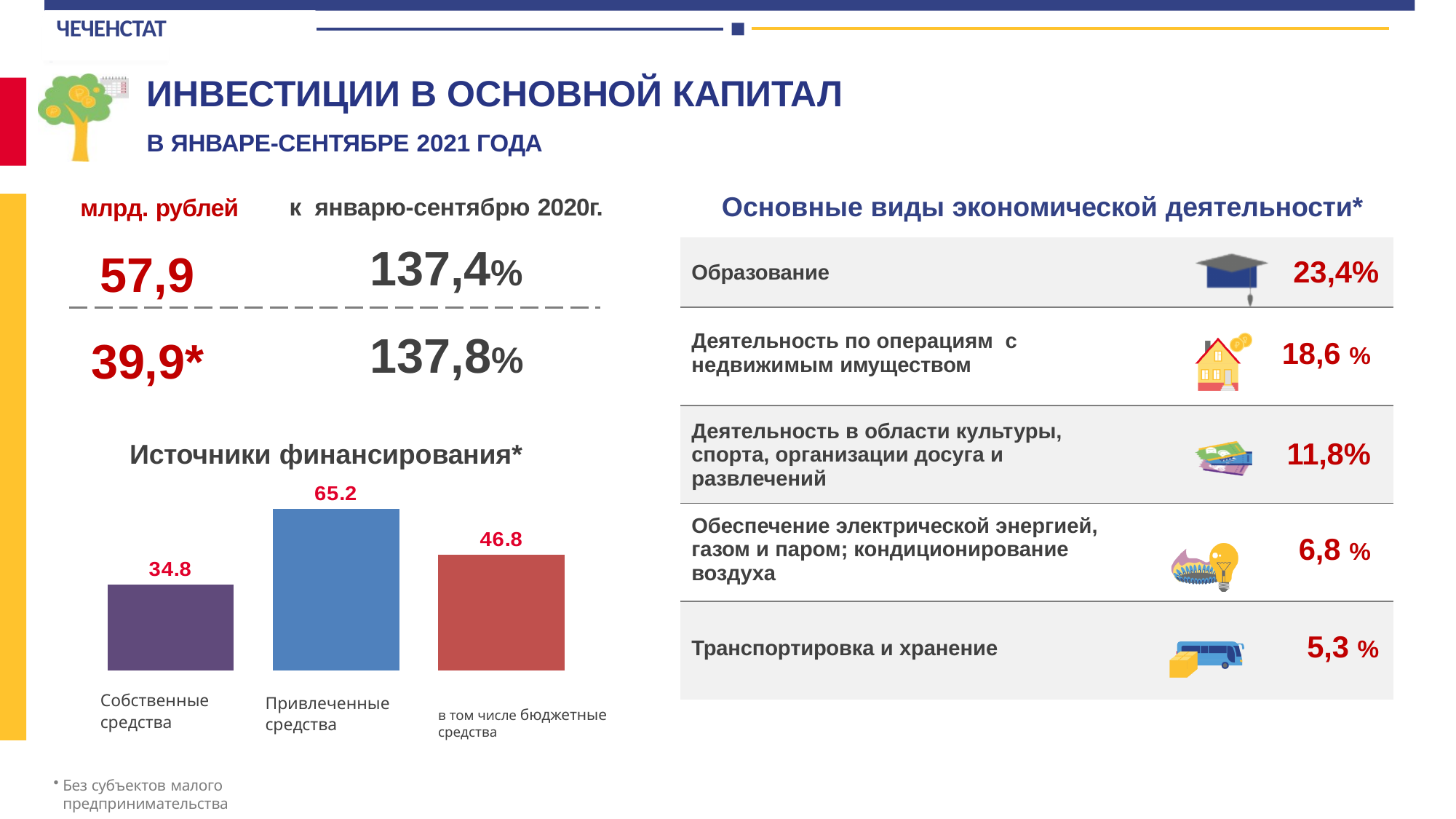
What is the value for Собственные средства in the Источники финансирования chart? 34.8 Which category has the lowest value in the Источники финансирования chart? Собственные средства What colour is the bar for Привлеченные средства in the Источники финансирования chart? blue What is the difference between Привлеченные средства and в том числе бюджетные средства in the Источники финансирования chart? 18.4 Which is larger in the Источники финансирования chart: Собственные средства or в том числе бюджетные средства? в том числе бюджетные средства Which category has the highest value in the Источники финансирования chart? Привлеченные средства What is the value for Привлеченные средства in the Источники финансирования chart? 65.2 What is the difference between Привлеченные средства and Собственные средства in the Источники финансирования chart? 30.4 How many bars are shown in the Источники финансирования chart? 3 What type of chart is Источники финансирования? bar chart What is the title of the bar chart on the slide? Источники финансирования* What is the value for в том числе бюджетные средства in the Источники финансирования chart? 46.8